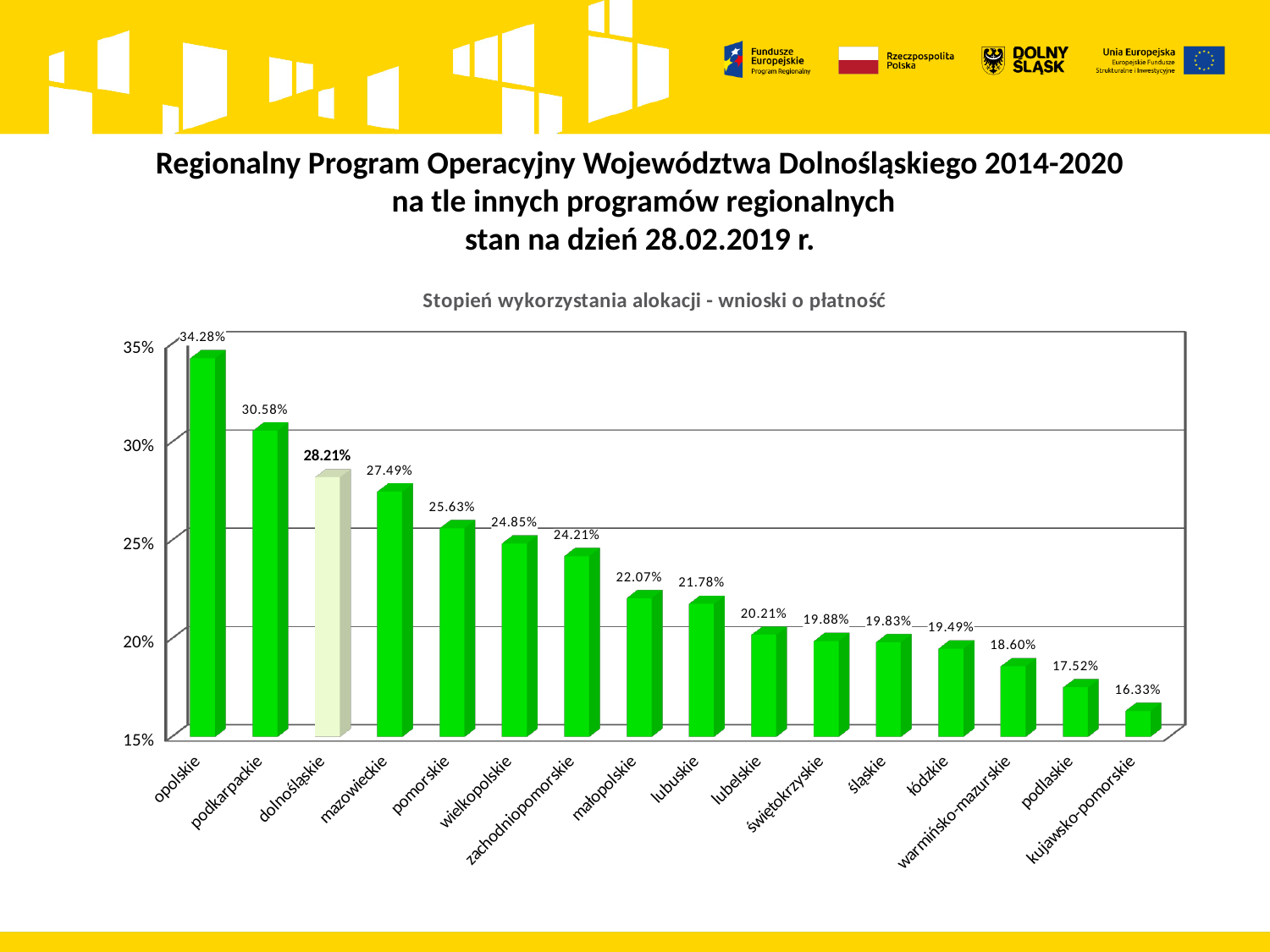
What is the value for opolskie? 34.28% Do the values rise or fall from left to right along the x axis? fall What is the value for warmińsko-mazurskie? 18.60% Which has a larger value, lubuskie or lubelskie? lubuskie How many regions are shown on the chart? 16 What is the difference between the values for dolnośląskie and mazowieckie? 0.72 percentage points What kind of chart is shown? bar chart Which region has the highest value? opolskie What is the difference between the values for opolskie and kujawsko-pomorskie? 17.95 percentage points Which region has the lowest value? kujawsko-pomorskie Is the value for pomorskie greater or less than 25%? greater What is the value for dolnośląskie? 28.21%